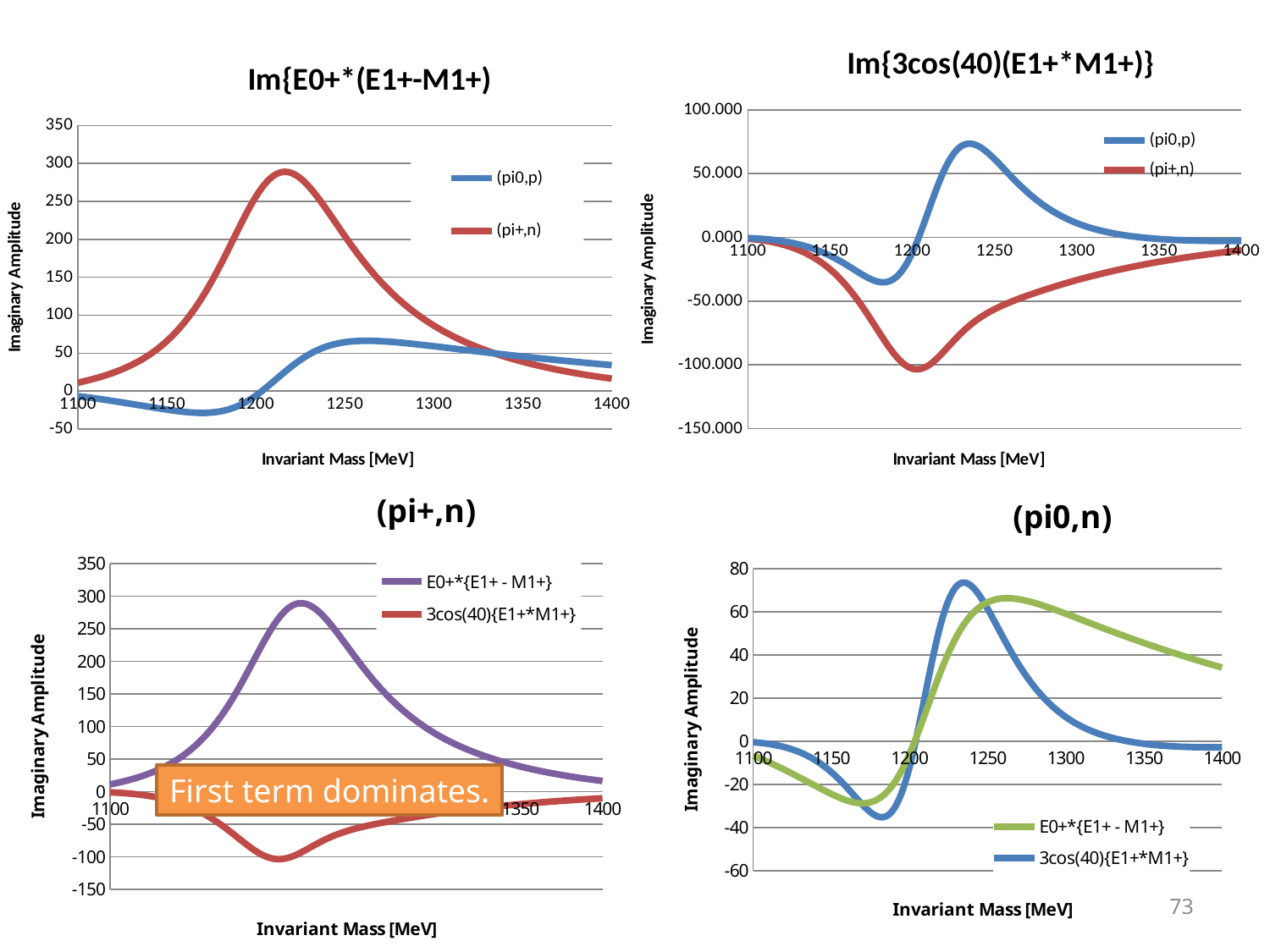
In the bottom-left chart titled (pi+,n), what are the two legend entries? E0+*{E1+ - M1+} and 3cos(40){E1+*M1+} In the top-left chart titled Im{E0+*(E1+-M1+)}, at 1400 MeV which series has the larger value, (pi0,p) or (pi+,n)? (pi0,p) What kind of chart is the top-left chart titled Im{E0+*(E1+-M1+)}? line chart In the top-left chart titled Im{E0+*(E1+-M1+)}, how many series does the legend list? 2 In the top-left chart titled Im{E0+*(E1+-M1+)}, is the peak value of the (pi+,n) series greater or less than 250? greater In the bottom-left chart titled (pi+,n), how many series does the legend list? 2 In the top-left chart titled Im{E0+*(E1+-M1+)}, at 1200 MeV which series has the larger value, (pi0,p) or (pi+,n)? (pi+,n) In the bottom-right chart titled (pi0,n), at 1300 MeV which series has the larger value, E0+*{E1+ - M1+} or 3cos(40){E1+*M1+}? E0+*{E1+ - M1+} In the bottom-right chart titled (pi0,n), what is the x-axis label? Invariant Mass [MeV] In the top-right chart titled Im{3cos(40)(E1+*M1+)}, does the (pi+,n) series rise or fall between 1250 and 1400 MeV? rise In the top-right chart titled Im{3cos(40)(E1+*M1+)}, is the peak value of the (pi0,p) series greater or less than 50.000? greater In the top-right chart titled Im{3cos(40)(E1+*M1+)}, is the minimum value of the (pi+,n) series greater or less than -50.000? less